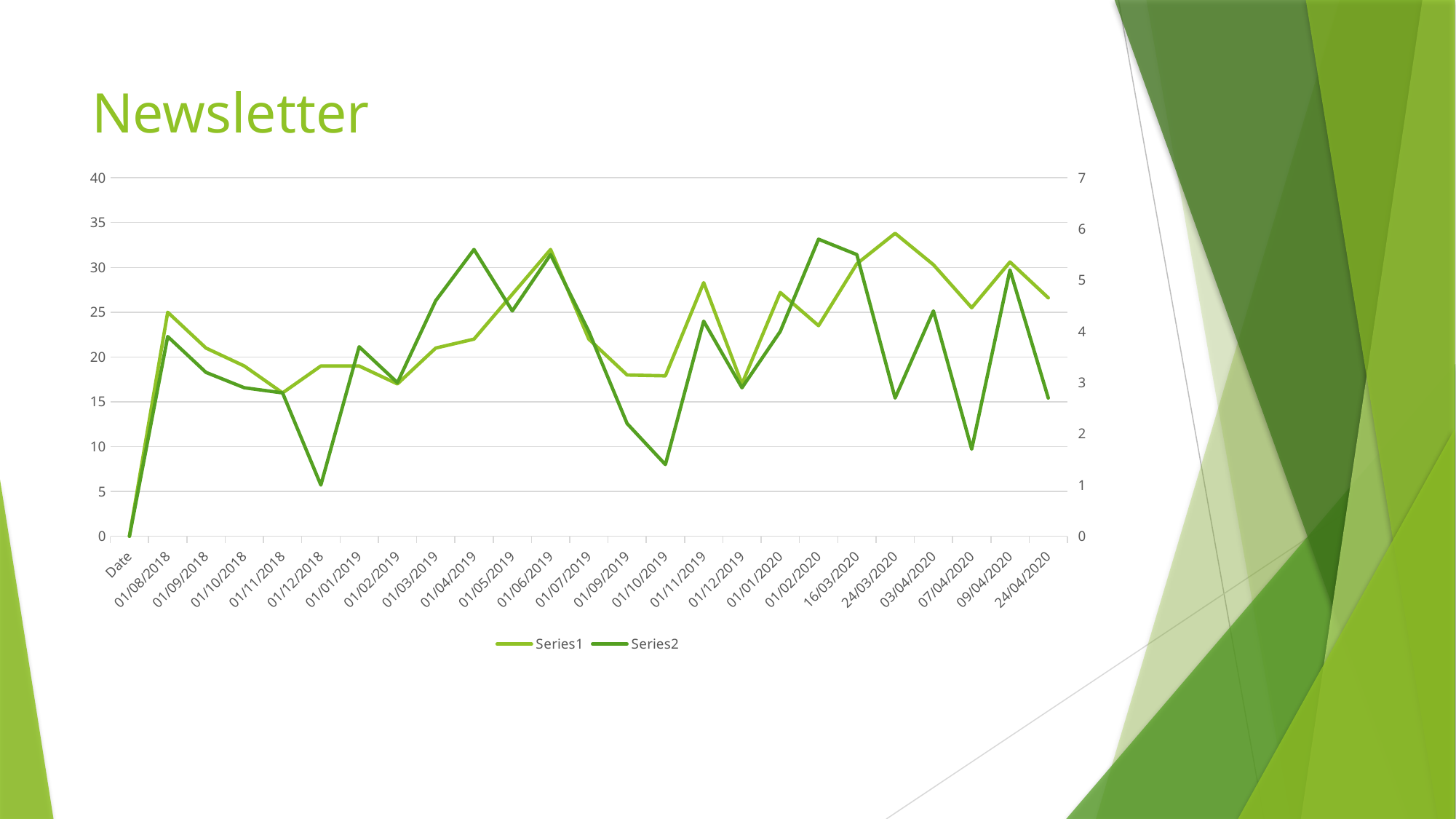
What are the two entries in the chart legend? Series1 and Series2 Is the value for Series1 at 01/09/2019 greater or less than 20 on the left axis? less Is the value for Series2 at 01/04/2019 greater or less than 5 on the right axis? greater What kind of chart is shown on the slide? line chart Which is larger for Series1: the value at 01/11/2019 or the value at 01/12/2019? 01/11/2019 Is the value for Series1 at 24/03/2020 greater or less than 30 on the left axis? greater What is the highest value shown on the left vertical axis? 40 How many series does the chart legend list? 2 Excluding the first point labelled Date, at which date does Series2 reach its lowest value? 01/12/2018 At which date does Series1 reach its highest value? 24/03/2020 Does Series1 rise or fall between 24/03/2020 and 07/04/2020? fall